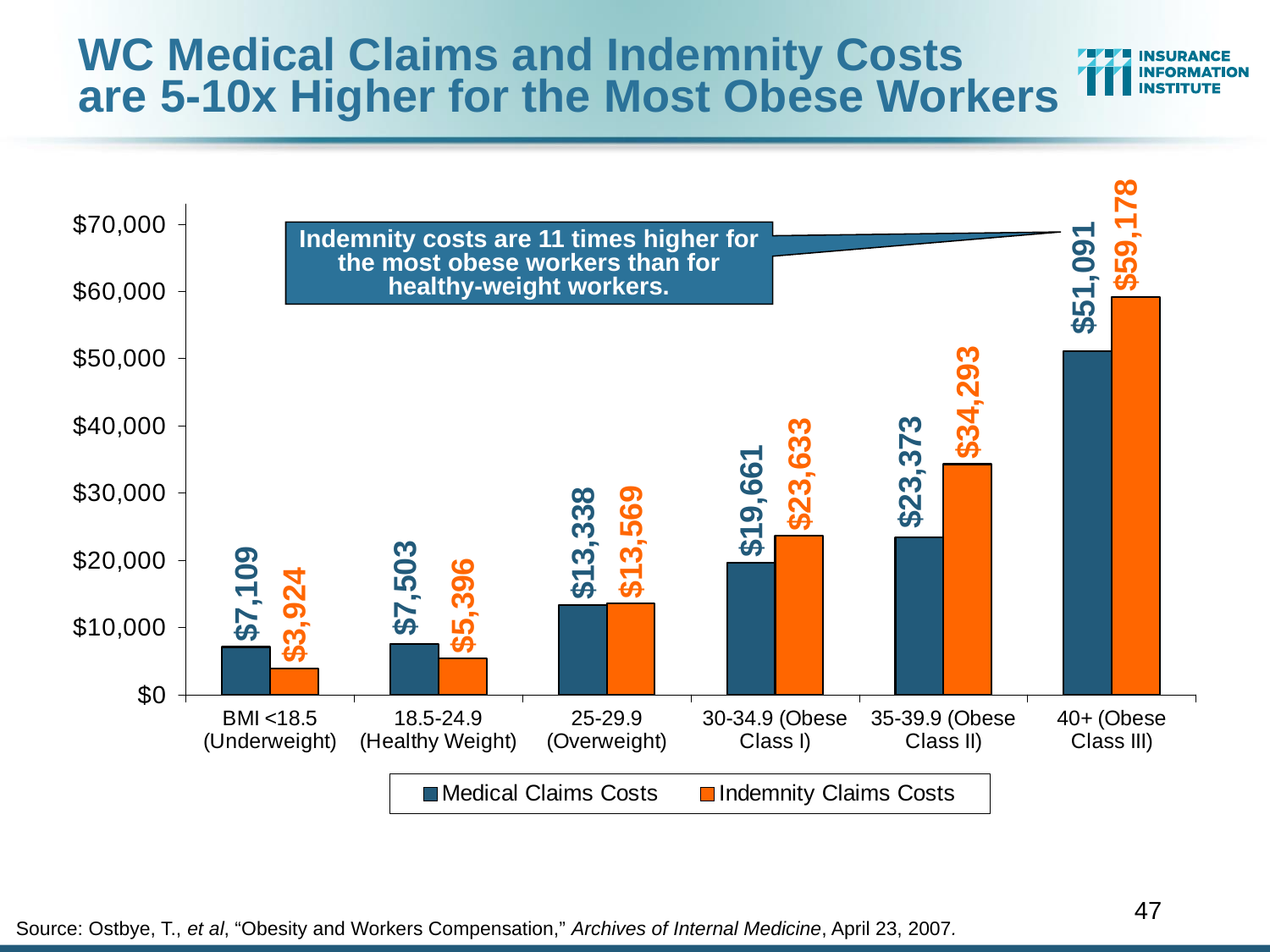
How many BMI categories are shown on the x axis? 6 How many series does the legend list? 2 Which is larger for the BMI <18.5 (Underweight) category: Medical Claims Costs or Indemnity Claims Costs? Medical Claims Costs Is the Indemnity Claims Costs value for 40+ (Obese Class III) greater or less than $50,000? greater What is the Medical Claims Costs value for the 40+ (Obese Class III) category? $51,091 What kind of chart is shown on the slide? Bar chart What is the Indemnity Claims Costs value for the 18.5-24.9 (Healthy Weight) category? $5,396 What is the difference between Indemnity Claims Costs and Medical Claims Costs for the 35-39.9 (Obese Class II) category? $10,920 What is the Indemnity Claims Costs value for the 30-34.9 (Obese Class I) category? $23,633 Which category has the highest Indemnity Claims Costs? 40+ (Obese Class III) Do the Medical Claims Costs values rise or fall as BMI increases along the x axis? Rise Which category has the lowest Medical Claims Costs? BMI <18.5 (Underweight)